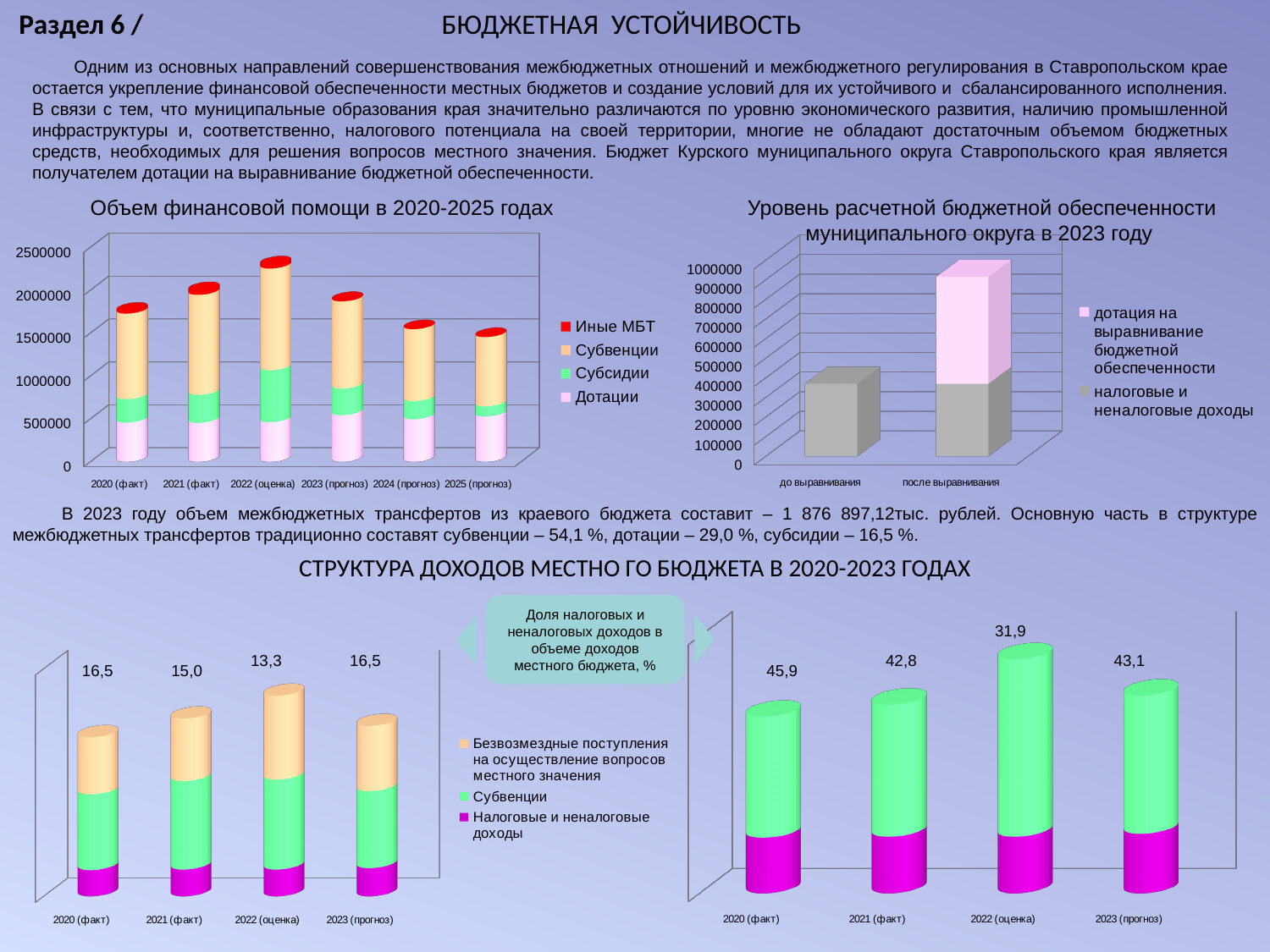
How many series does the legend of the chart "Объем финансовой помощи в 2020-2025 годах" list? 4 In the bottom-right chart under "СТРУКТУРА ДОХОДОВ МЕСТНОГО БЮДЖЕТА В 2020-2023 ГОДАХ", what value is labelled for 2021 (факт)? 42,8 In the chart "Объем финансовой помощи в 2020-2025 годах", is the total for 2020 (факт) greater or less than 1500000? greater What kind of chart is "Объем финансовой помощи в 2020-2025 годах"? Bar chart In the chart "Уровень расчетной бюджетной обеспеченности муниципального округа в 2023 году", is the value for "до выравнивания" greater or less than 500000? less In the bottom-right chart under "СТРУКТУРА ДОХОДОВ МЕСТНОГО БЮДЖЕТА В 2020-2023 ГОДАХ", what is the difference between the labelled values for 2020 (факт) and 2022 (оценка)? 14,0 In the chart "Объем финансовой помощи в 2020-2025 годах", which category has the tallest stacked bar? 2022 (оценка) How many series does the legend of the bottom-left chart under "СТРУКТУРА ДОХОДОВ МЕСТНОГО БЮДЖЕТА В 2020-2023 ГОДАХ" list? 3 In the chart "Объем финансовой помощи в 2020-2025 годах", which category has the shortest stacked bar? 2025 (прогноз) In the chart "Уровень расчетной бюджетной обеспеченности муниципального округа в 2023 году", which bar is taller: "до выравнивания" or "после выравнивания"? после выравнивания How many categories are shown on the x axis of the chart "Объем финансовой помощи в 2020-2025 годах"? 6 In the bottom-left chart under "СТРУКТУРА ДОХОДОВ МЕСТНОГО БЮДЖЕТА В 2020-2023 ГОДАХ", what value is labelled for 2022 (оценка)? 13,3